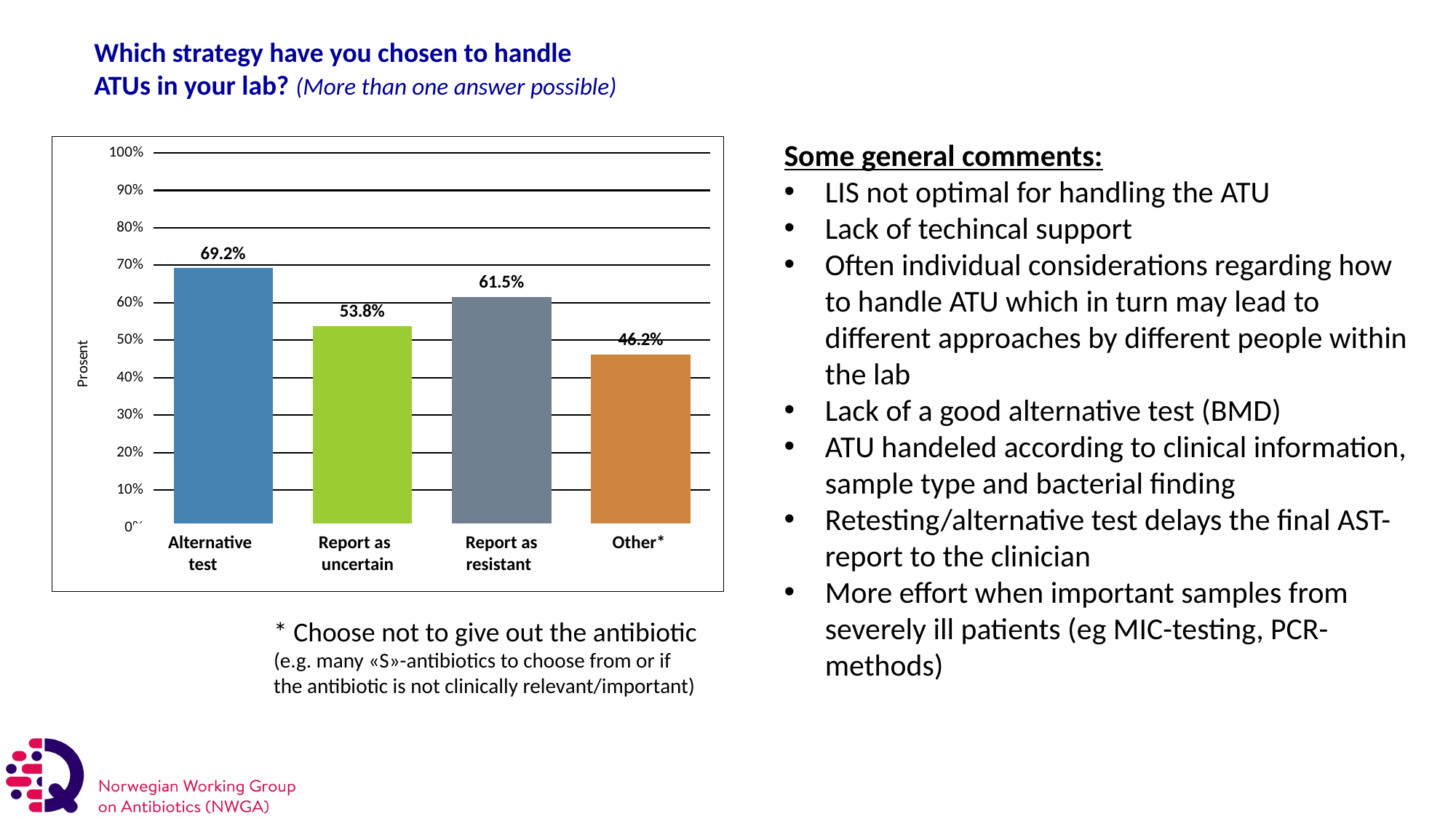
What is the label on the vertical axis of the chart? Prosent Which category has the lowest value? Other* What is the value for Alternative test? 69.2% Is the value for Other* greater or less than 50%? less Which is larger, the value for Report as resistant or the value for Report as uncertain? Report as resistant What is the value for Report as resistant? 61.5% What is the value for Report as uncertain? 53.8% What is the value for Other*? 46.2% How many categories are shown on the chart? 4 Which category has the highest value? Alternative test What is the difference between the values for Alternative test and Report as uncertain? 15.4% What kind of chart is shown on the slide? bar chart